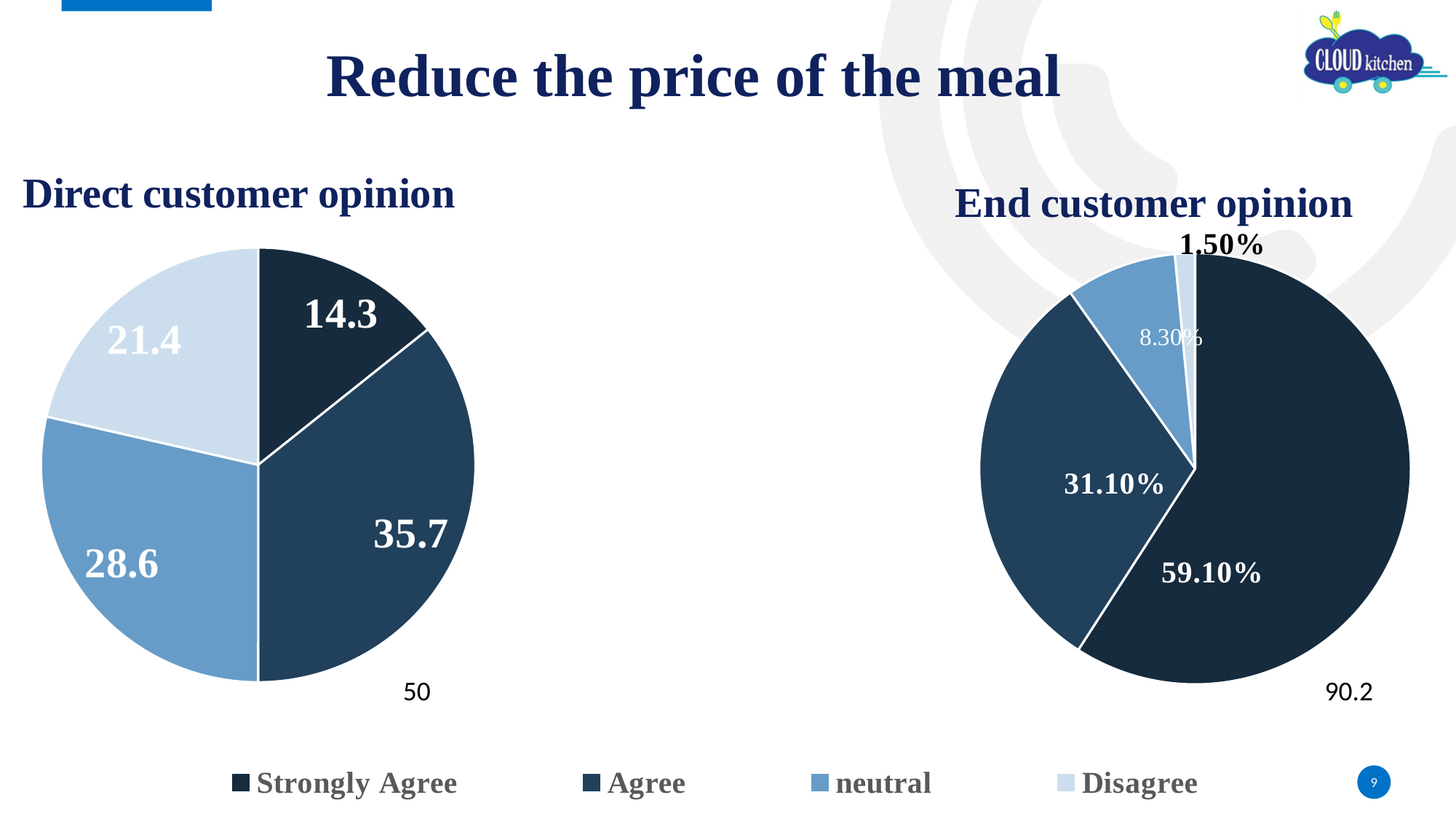
In the Direct customer opinion chart, what is the value for Agree? 35.7 In the Direct customer opinion chart, what is the value for Disagree? 21.4 In the Direct customer opinion chart, which is larger, neutral or Disagree? neutral What type of chart is used for Direct customer opinion? Pie chart How many slices does the End customer opinion chart have? 4 In the End customer opinion chart, which category has the smallest slice? Disagree In the End customer opinion chart, what is the value for Strongly Agree? 59.10% In the Direct customer opinion chart, which category has the largest slice? Agree In the End customer opinion chart, what is the difference between Strongly Agree and Agree? 28.00% How many entries does the legend list? 4 In the Direct customer opinion chart, what is the difference between the Agree and Strongly Agree values? 21.4 In the End customer opinion chart, what is the value for neutral? 8.30%